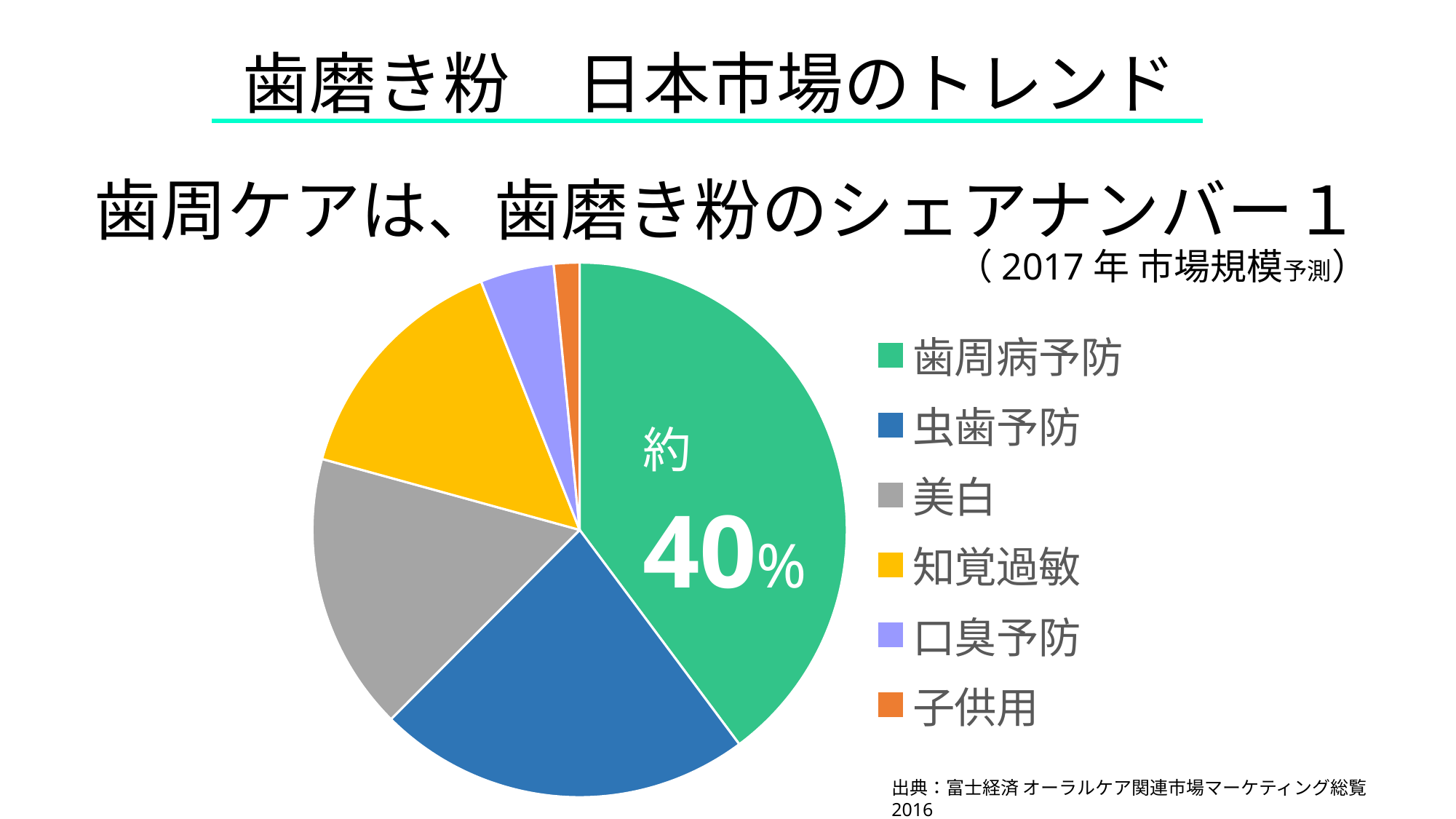
How many entries does the legend list? 6 Which slice is larger, 口臭予防 or 子供用? 口臭予防 How many categories does the pie chart have? 6 Which slice is larger, 虫歯予防 or 美白? 虫歯予防 Which category has the smallest slice of the pie? 子供用 Which category has the largest slice of the pie? 歯周病予防 What label is printed on the 歯周病予防 slice? 約40% Which category is shown in orange in the pie chart? 子供用 Which category is shown in green in the pie chart? 歯周病予防 Which slice is larger, 知覚過敏 or 口臭予防? 知覚過敏 What kind of chart is shown on the slide? pie chart